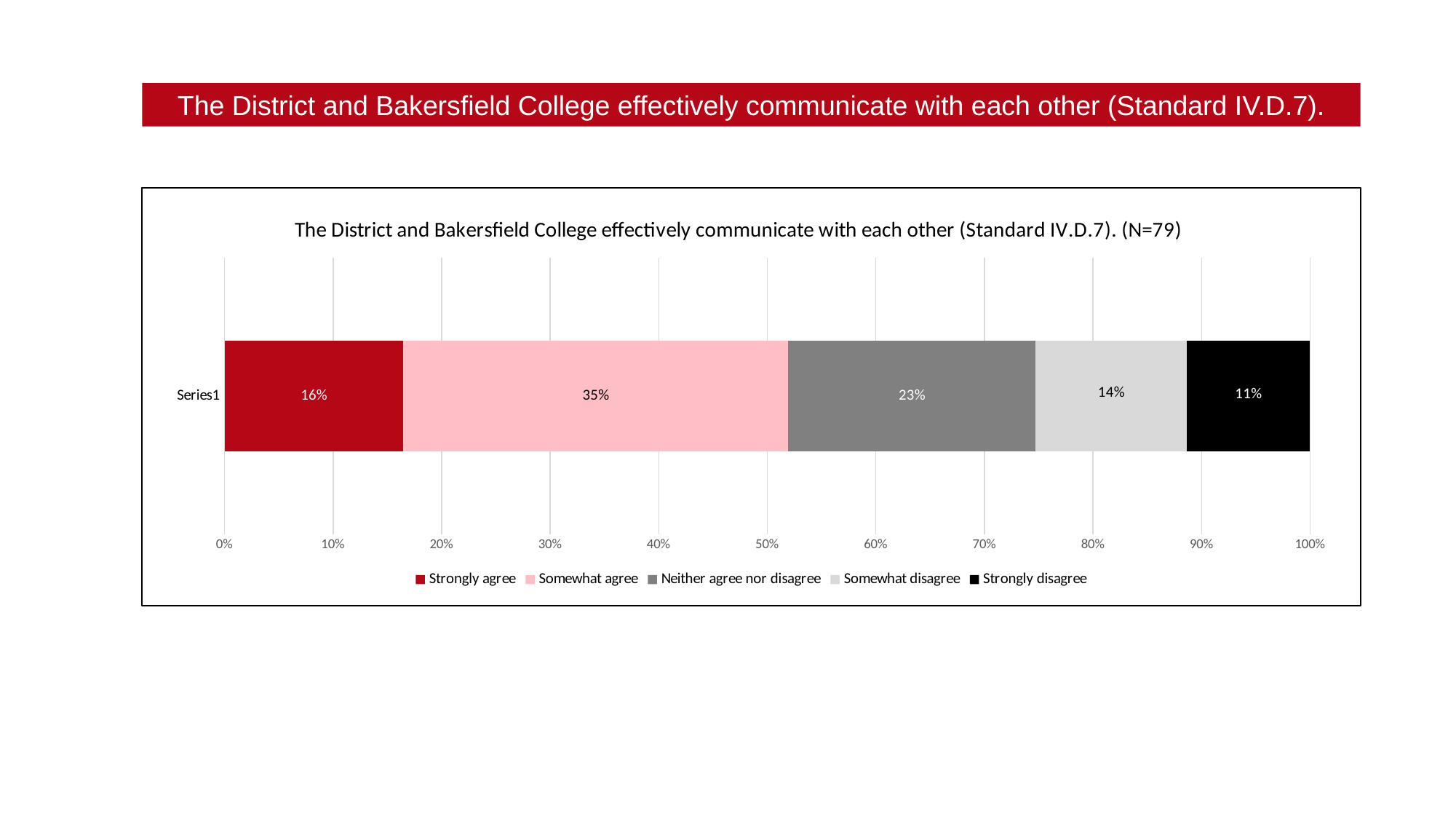
Which is larger, the percentage for "Strongly agree" or for "Somewhat disagree"? Strongly agree What kind of chart is shown on the slide? Stacked bar chart What percentage of respondents selected "Strongly disagree"? 11% What percentage of respondents selected "Neither agree nor disagree"? 23% What percentage of respondents selected "Somewhat disagree"? 14% Which response option has the lowest percentage? Strongly disagree What is the difference in percentage points between "Somewhat agree" and "Neither agree nor disagree"? 12 What is the sample size (N) stated in the chart title? 79 Which response option has the highest percentage? Somewhat agree What percentage of respondents selected "Somewhat agree"? 35% How many series does the legend list? 5 What percentage of respondents selected "Strongly agree"? 16%